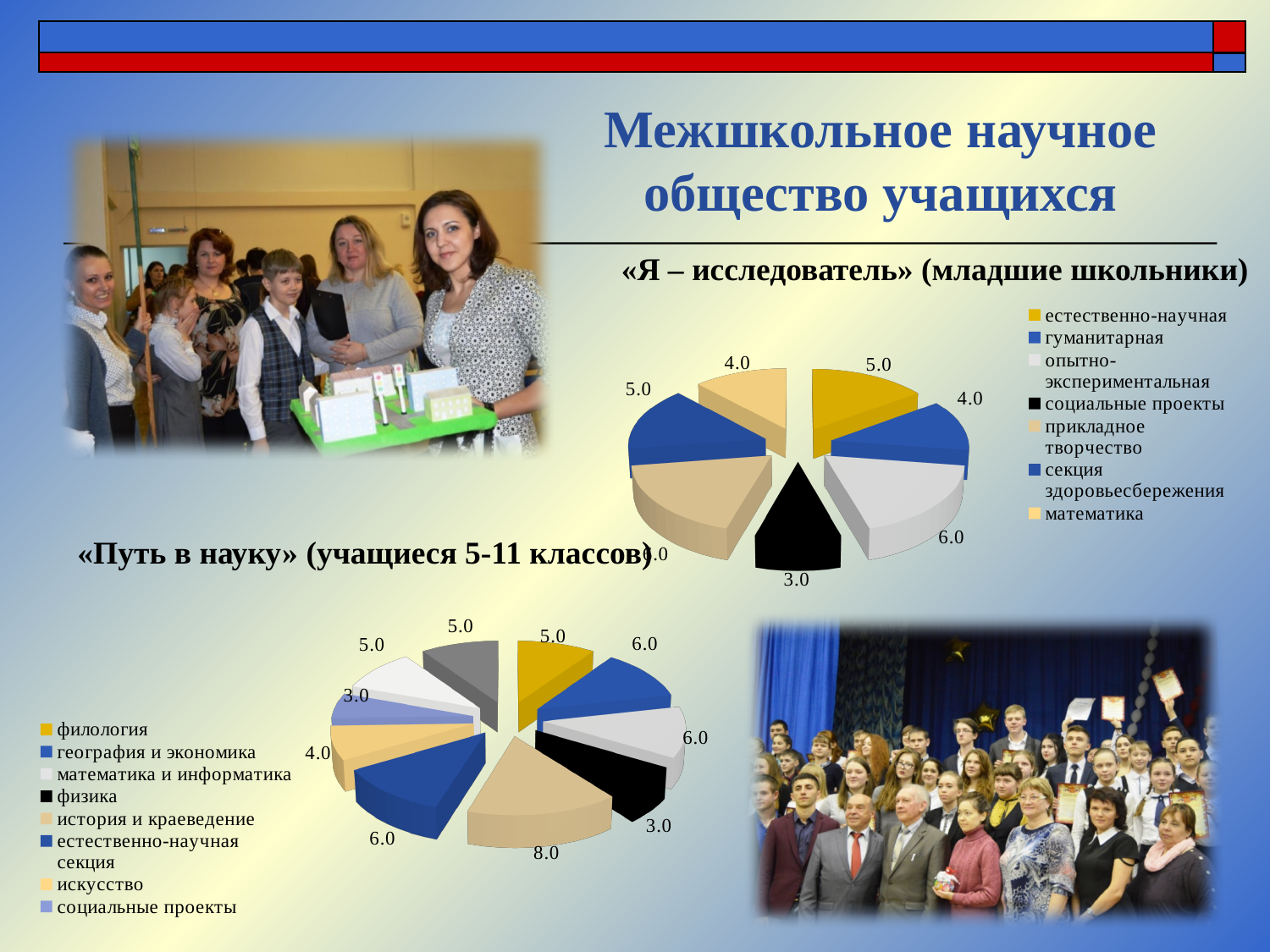
In the «Путь в науку» chart, what is the difference between история и краеведение and филология? 3.0 How many entries does the legend of the «Я – исследователь» chart list? 7 In the «Я – исследователь» chart, which is larger: гуманитарная or опытно-экспериментальная? опытно-экспериментальная In the «Я – исследователь» chart, which category has the smallest value? социальные проекты In the «Путь в науку» chart, what is the value for физика? 3.0 In the «Путь в науку» chart, what is the value for искусство? 4.0 What kind of chart is used for «Я – исследователь» (младшие школьники)? pie chart In the «Я – исследователь» chart, what is the value for естественно-научная? 5.0 In the «Путь в науку» chart, what is the value for история и краеведение? 8.0 In the «Путь в науку» chart, which category has the largest value? история и краеведение How many entries does the legend of the «Путь в науку» chart list? 8 In the «Я – исследователь» chart, what is the value for социальные проекты? 3.0